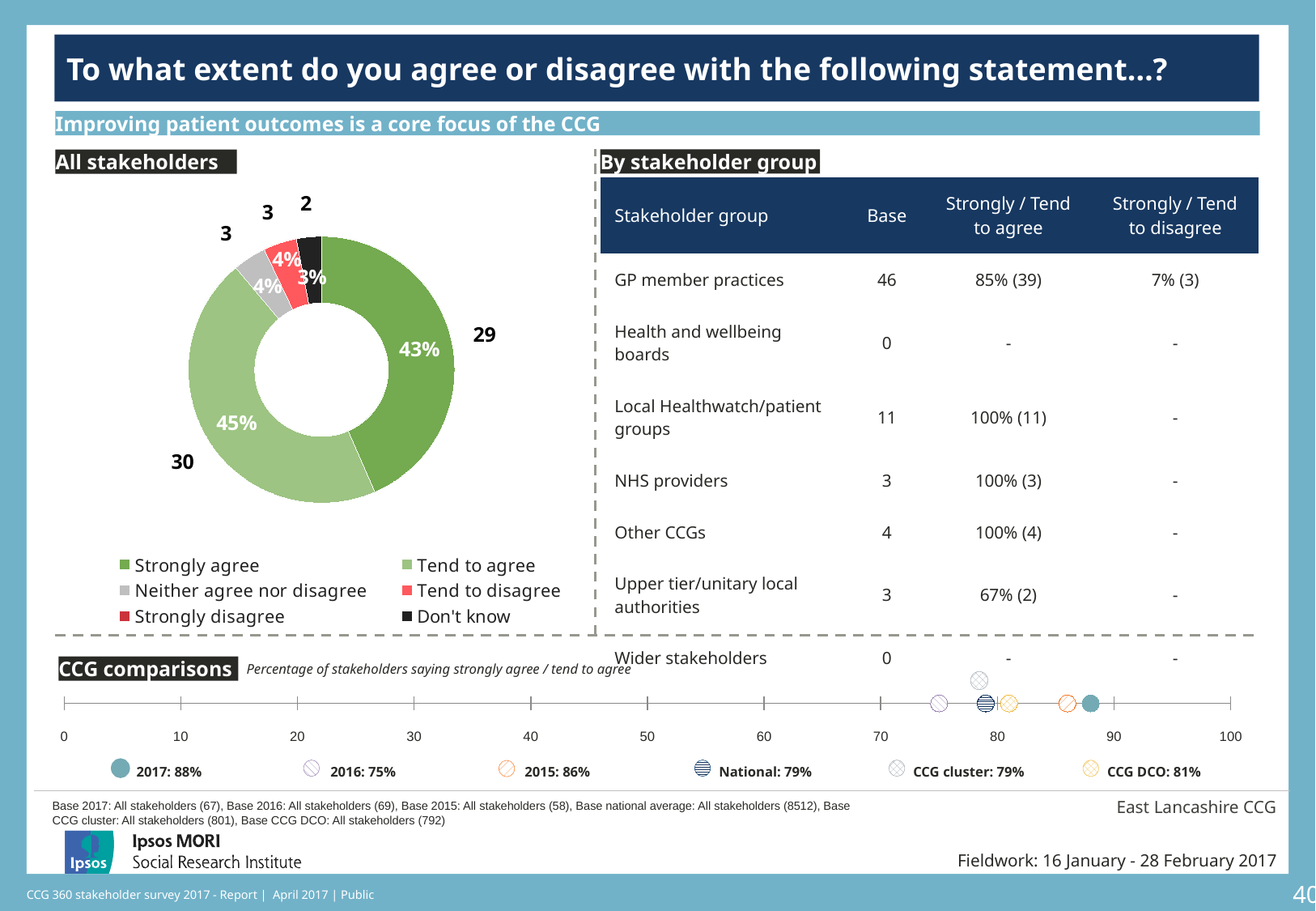
How many response categories does the legend of the All stakeholders donut chart list? 6 What type of chart is used for the All stakeholders section? Donut chart In the All stakeholders donut chart, what is the difference in percentage points between Tend to agree and Strongly agree? 2 In the All stakeholders donut chart, which is larger: the share for Neither agree nor disagree or the share for Don't know? Neither agree nor disagree In the CCG comparisons chart, what percentage of stakeholders said strongly agree / tend to agree in 2017? 88% In the All stakeholders donut chart, what percentage of stakeholders tend to agree? 45% In the CCG comparisons chart, what is the National value? 79% In the CCG comparisons chart, which year has the lowest value? 2016 In the CCG comparisons chart, what is the difference between the 2017 value and the 2016 value? 13 percentage points In the All stakeholders donut chart, what percentage of stakeholders answered Don't know? 3% In the All stakeholders donut chart, what percentage of stakeholders strongly agree? 43% In the All stakeholders donut chart, which response category has the largest share? Tend to agree